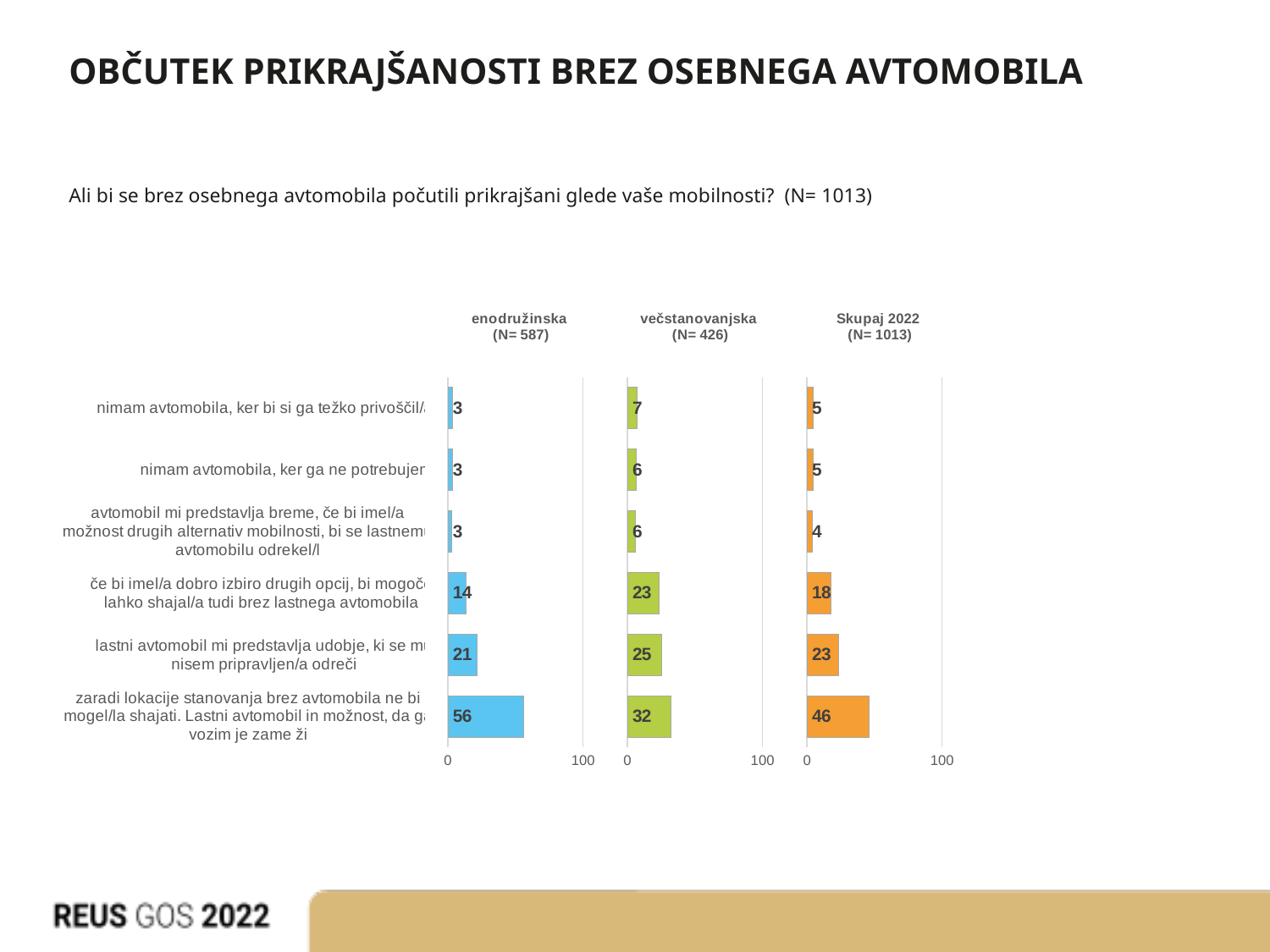
In the 'večstanovanjska (N= 426)' chart, which category has the lowest value? nimam avtomobila, ker ga ne potrebujem and avtomobil mi predstavlja breme (both 6) What colour are the bars in the 'Skupaj 2022 (N= 1013)' chart? orange How many categories are shown in each of the bar charts? 6 In the 'Skupaj 2022 (N= 1013)' chart, is the value for 'zaradi lokacije stanovanja brez avtomobila ne bi mogel/la shajati' greater or less than 100? less What kind of chart is used on this slide? bar chart For 'če bi imel/a dobro izbiro drugih opcij', which is larger: the 'enodružinska' value or the 'večstanovanjska' value? večstanovanjska In the 'enodružinska (N= 587)' chart, what is the value for 'lastni avtomobil mi predstavlja udobje, ki se mu nisem pripravljen/a odreči'? 21 In the 'enodružinska (N= 587)' chart, which category has the highest value? zaradi lokacije stanovanja brez avtomobila ne bi mogel/la shajati What is the difference between the 'enodružinska' and 'večstanovanjska' values for 'zaradi lokacije stanovanja brez avtomobila ne bi mogel/la shajati'? 24 In the 'Skupaj 2022 (N= 1013)' chart, what is the value for 'zaradi lokacije stanovanja brez avtomobila ne bi mogel/la shajati'? 46 In the 'večstanovanjska (N= 426)' chart, what is the value for 'če bi imel/a dobro izbiro drugih opcij, bi mogoče lahko shajal/a tudi brez lastnega avtomobila'? 23 In the 'Skupaj 2022 (N= 1013)' chart, what is the value for 'nimam avtomobila, ker bi si ga težko privoščil/a'? 5